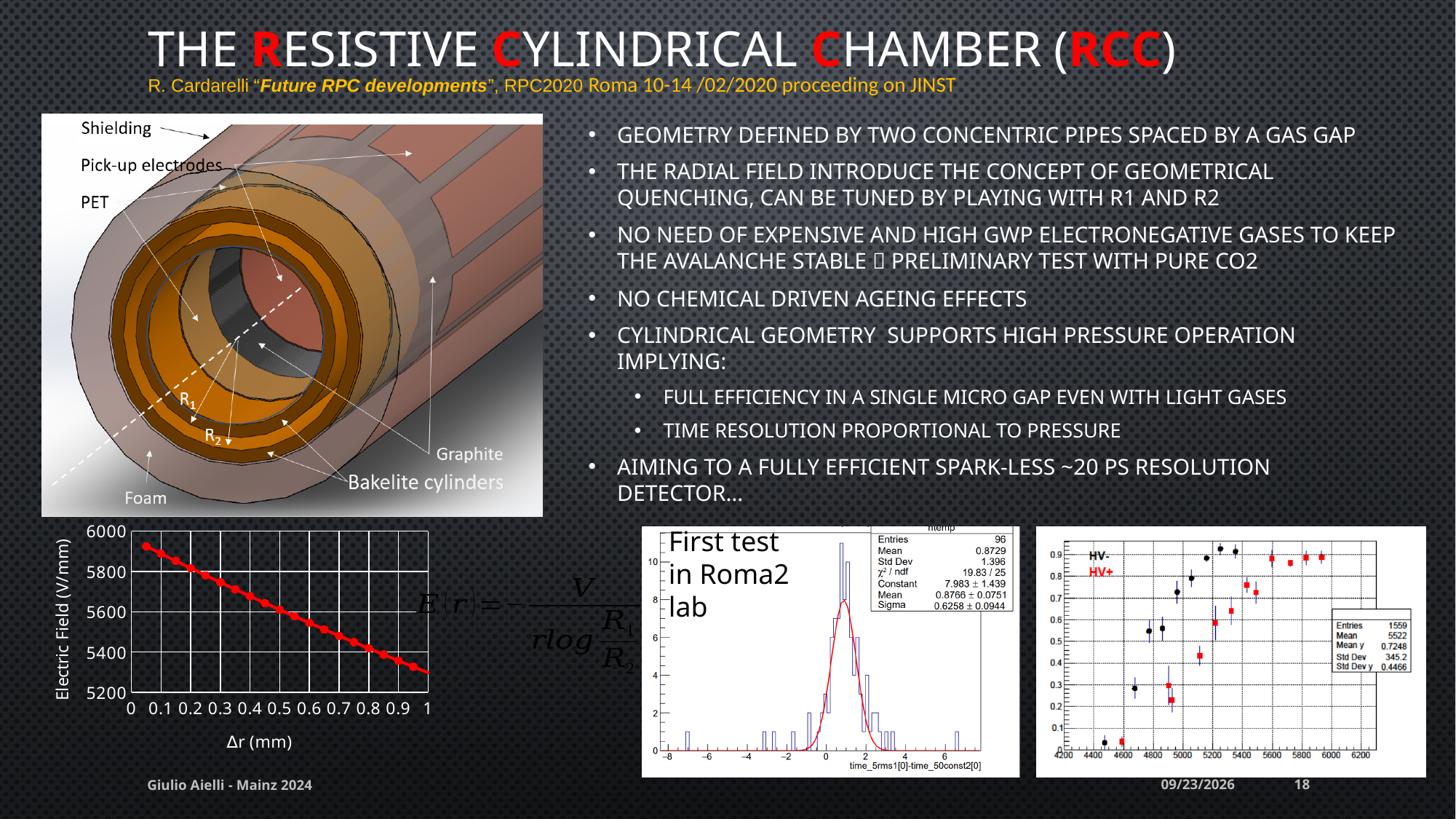
In the bottom-left Electric Field chart, is the value at Δr = 0.1 mm greater or less than 5800 V/mm? greater In the bottom-left Electric Field chart, does the electric field rise or fall as Δr increases from 0 to 1 mm? fall In the middle histogram (First test in Roma2 lab), what is the Std Dev shown in the statistics box? 1.396 What type of chart is the bottom-left chart of Electric Field versus Δr? line chart In the bottom-left Electric Field chart, is the value at Δr = 0.9 mm greater or less than 5400 V/mm? less In the bottom-right efficiency versus HV chart, do the HV- values rise or fall as HV increases? rise What is the y-axis label of the bottom-left chart? Electric Field (V/mm) In the bottom-right efficiency versus HV chart, which series is higher at an HV of about 5000: HV- or HV+? HV- How many series does the legend of the bottom-right efficiency versus HV chart list? 2 In the middle histogram (First test in Roma2 lab), what is the fitted Sigma shown in the statistics box? 0.6258 ± 0.0944 In the bottom-right efficiency versus HV chart, what is the Mean y value shown in the statistics box? 0.7248 In the middle histogram (First test in Roma2 lab), how many entries are listed in the statistics box? 96